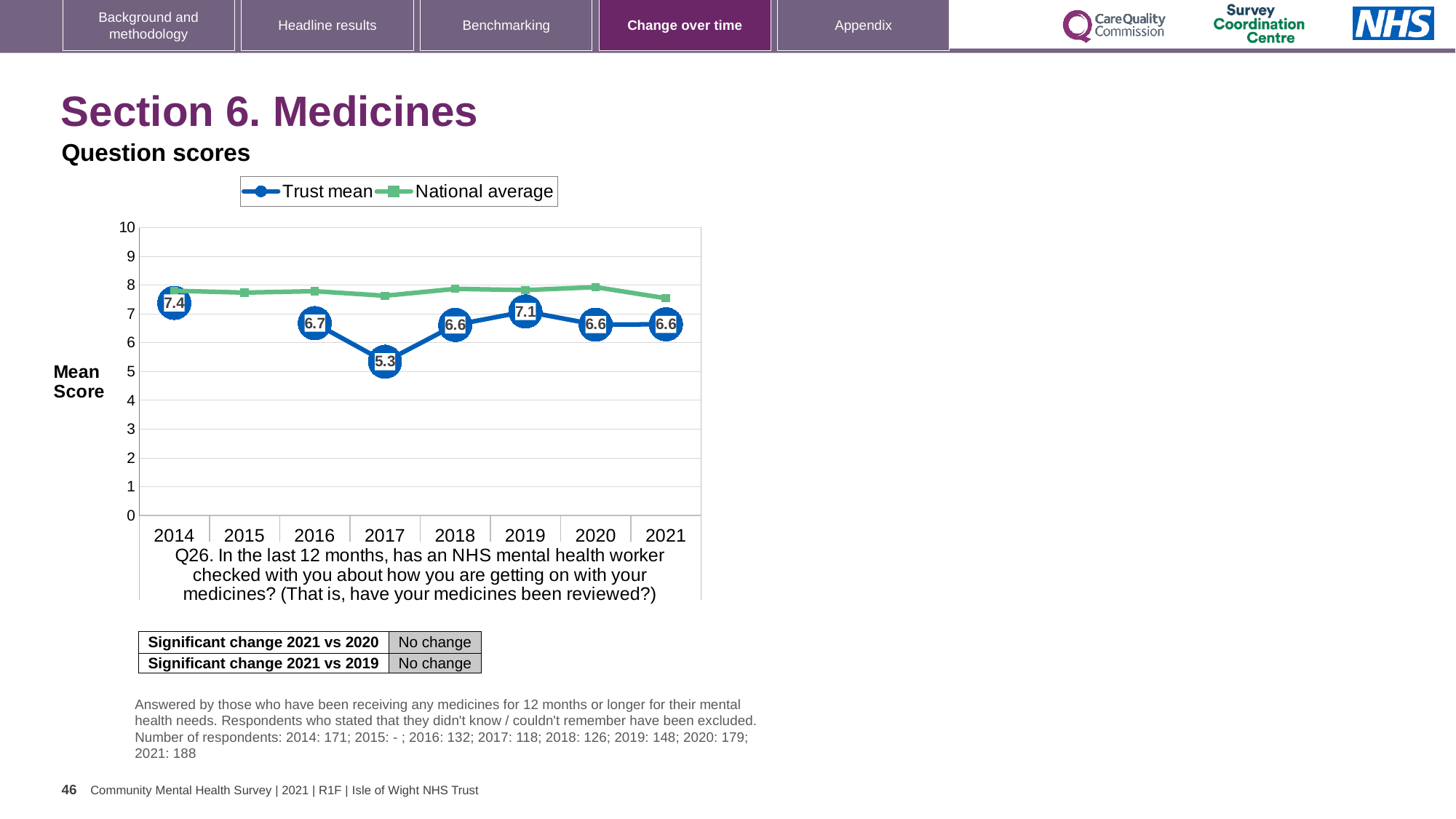
In which year is the Trust mean score lowest? 2017 What is the Trust mean score for 2019? 7.1 Did the Trust mean score rise or fall from 2016 to 2017? Fall What is the Trust mean score for 2014? 7.4 What is the Trust mean score for 2017? 5.3 Is the National average value for 2020 greater or less than 7? greater What is the difference between the Trust mean scores for 2019 and 2017? 1.8 Which is larger, the Trust mean score for 2016 or for 2017? 2016 How many series does the legend list? 2 What kind of chart is shown on the slide? Line chart In which year is the Trust mean score highest? 2014 What is the Trust mean score for 2021? 6.6